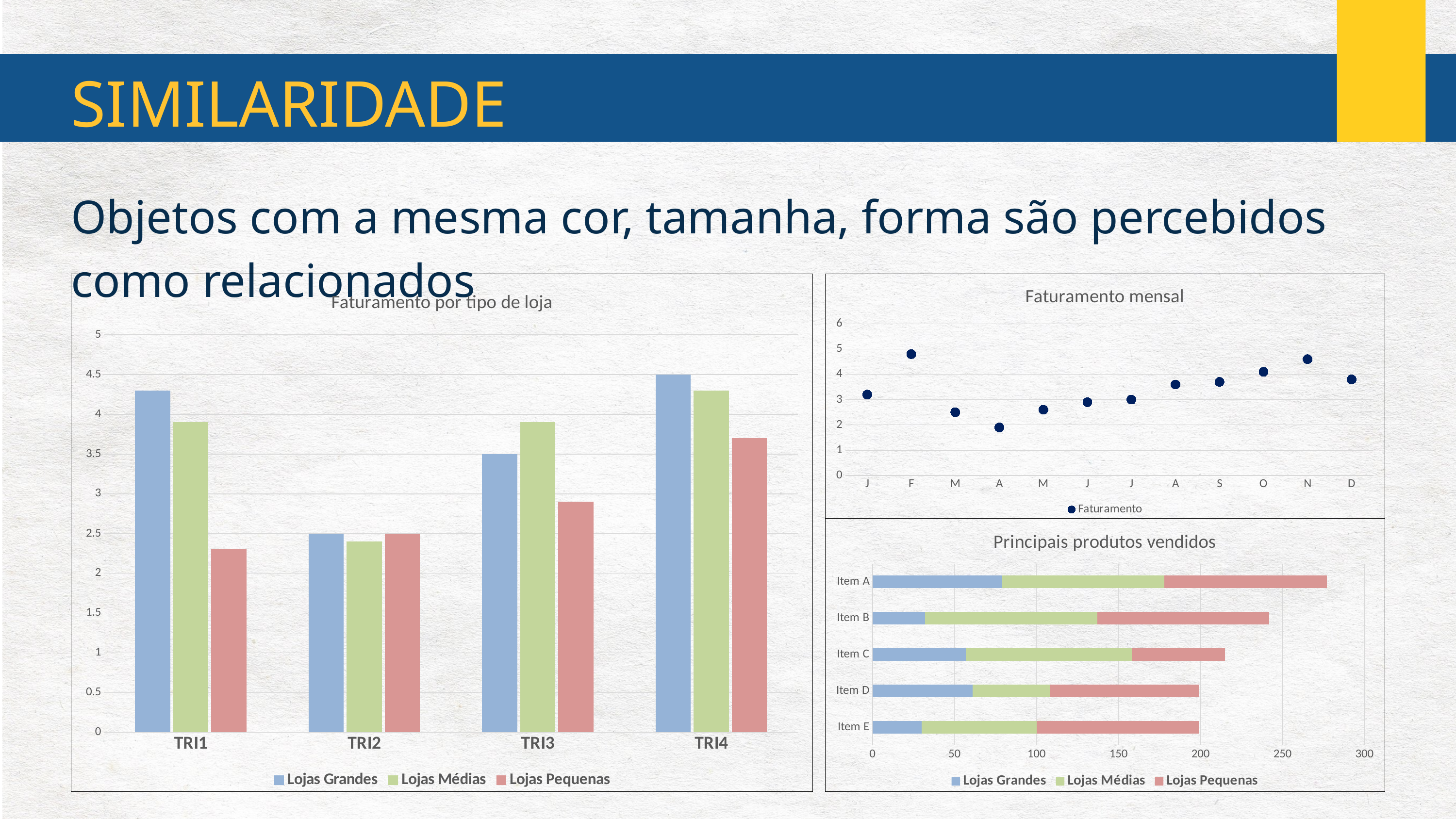
In the 'Faturamento por tipo de loja' chart, is the value for Lojas Grandes in TRI1 greater or less than 4? greater In the 'Faturamento por tipo de loja' chart, how many series does the legend list? 3 In the 'Principais produtos vendidos' chart, is the total for Item A greater or less than 250? greater In the 'Faturamento por tipo de loja' chart, which is larger in TRI3: Lojas Médias or Lojas Pequenas? Lojas Médias In the 'Faturamento por tipo de loja' chart, which quarter has the highest value for Lojas Grandes? TRI4 In the 'Faturamento por tipo de loja' chart, is the value for Lojas Pequenas in TRI1 greater or less than 2.5? less In the 'Faturamento mensal' chart, which month has the highest value? F (February) What kind of chart is 'Faturamento mensal'? scatter chart In the 'Principais produtos vendidos' chart, how many items are listed on the y axis? 5 In the 'Faturamento mensal' chart, which month has the lowest value? A (April) In the 'Faturamento por tipo de loja' chart, how many quarters are shown on the x axis? 4